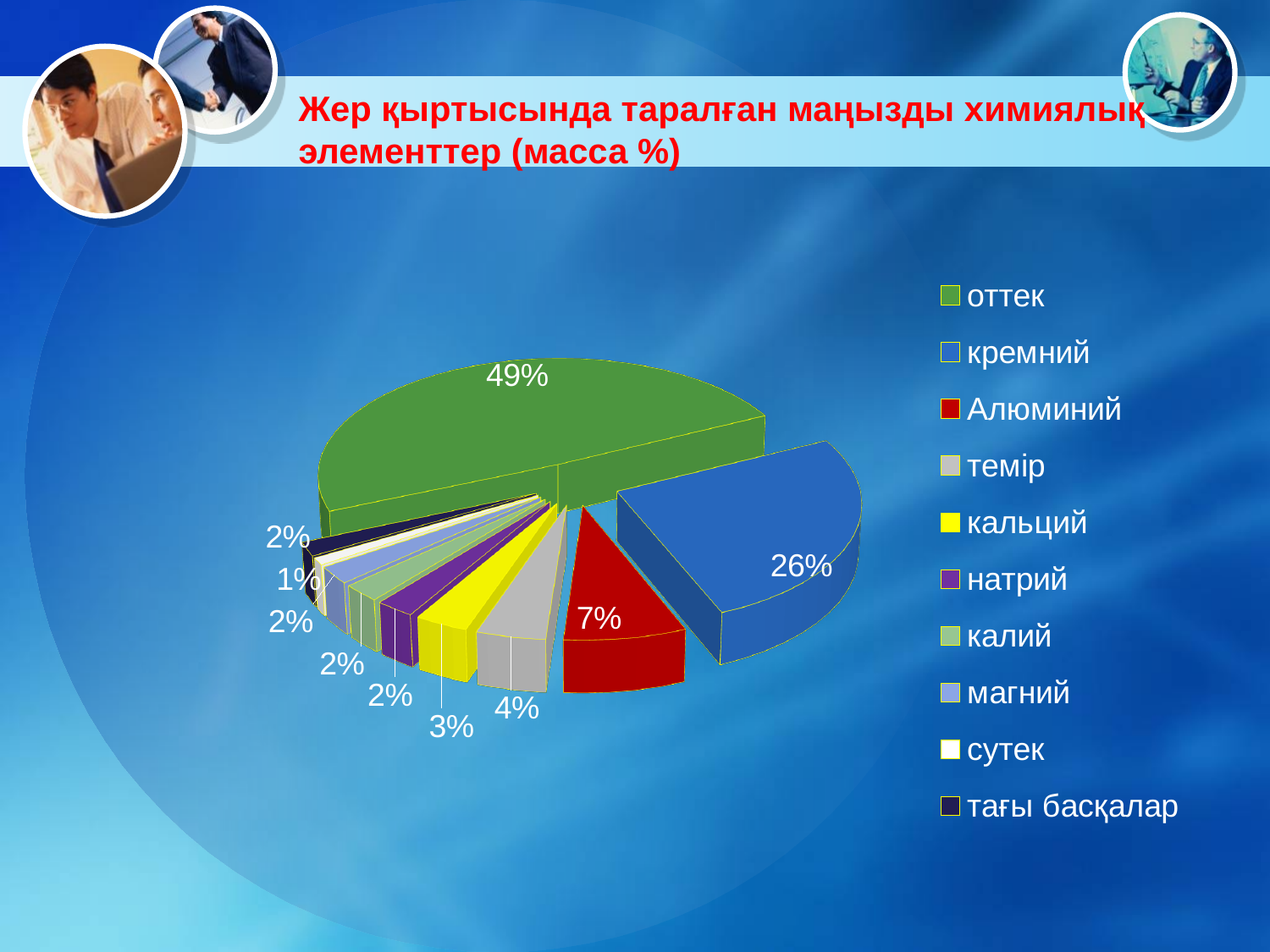
What percentage is shown for темір? 4% Which element has the largest slice of the pie? оттек Which is larger, the share for кремний or the share for Алюминий? кремний What is the difference in percentage points between оттек and кремний? 23 What is the value for Алюминий? 7% Which element has the smallest slice of the pie? сутек What colour is the slice for Алюминий? red What share of the pie does оттек have? 49% What kind of chart is shown on the slide? pie chart How many categories does the legend list? 10 What percentage is shown for кремний? 26% What is the value for кальций? 3%